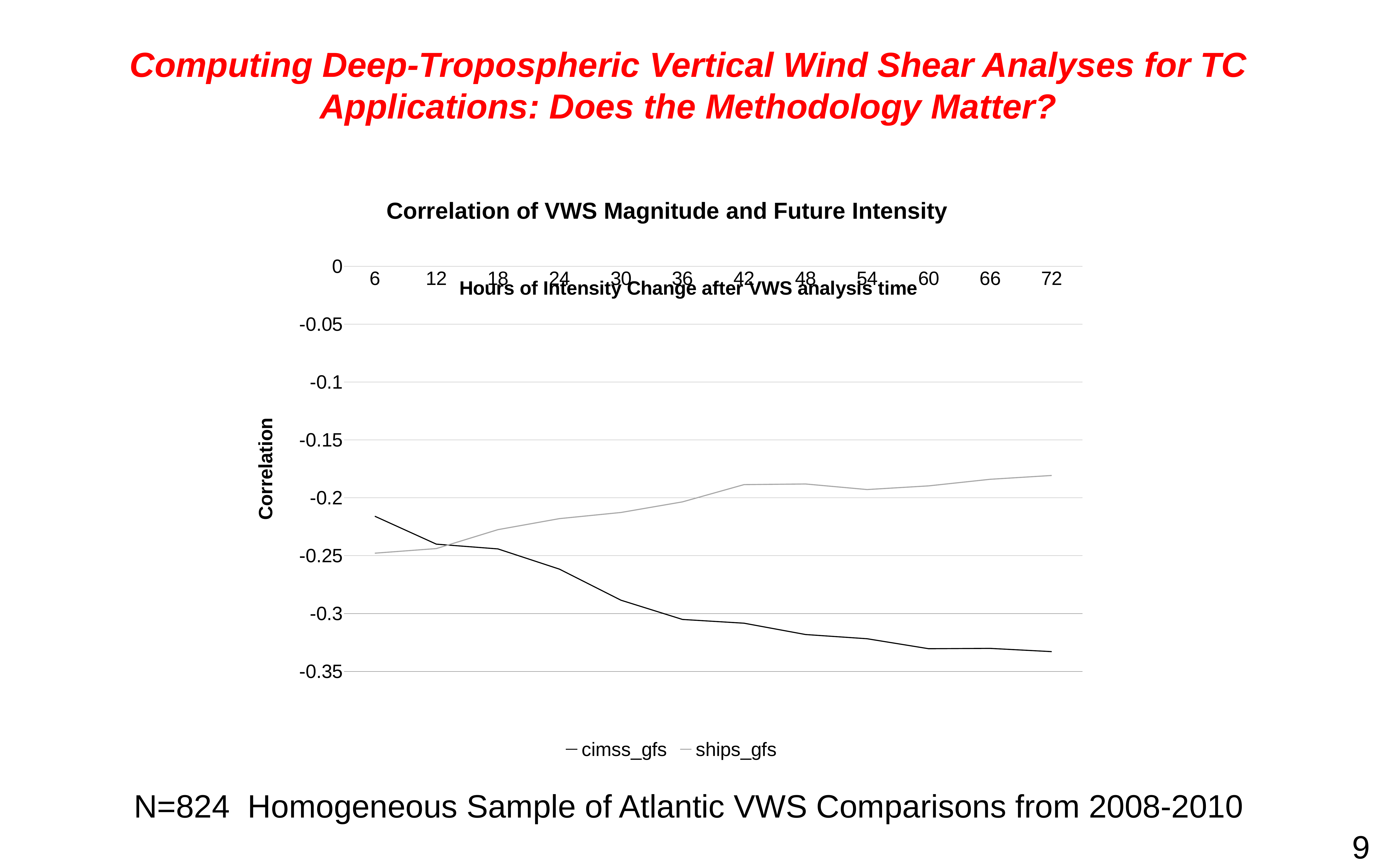
Does the cimss_gfs line rise or fall as the hours increase from 6 to 72? fall What is the title of the chart? Correlation of VWS Magnitude and Future Intensity Is the ships_gfs value at 72 hours greater or less than -0.2? greater At 6 hours, which series has the higher correlation value, cimss_gfs or ships_gfs? cimss_gfs How many points along the x axis does each line have? 12 Is the ships_gfs value at 6 hours greater or less than -0.2? less Is the cimss_gfs value at 72 hours greater or less than -0.3? less What kind of chart is shown on the slide? line chart How many series does the legend list? 2 At 72 hours, which series has the higher correlation value, cimss_gfs or ships_gfs? ships_gfs Does the ships_gfs line rise or fall as the hours increase from 6 to 72? rise